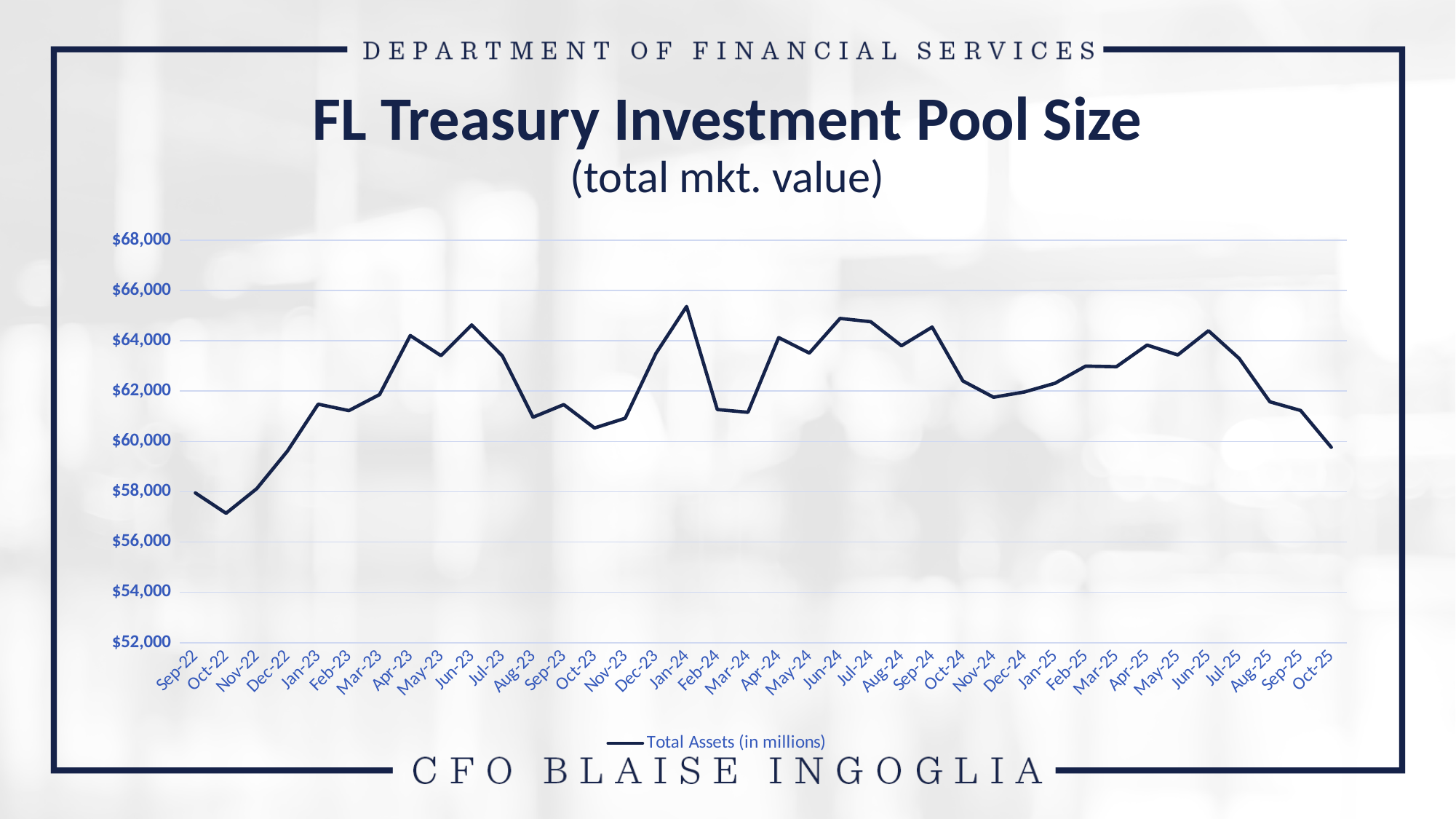
Which month has the highest total assets value? Jan-24 How many months are plotted along the x axis? 38 Is the value for Jan-24 greater or less than $64,000? greater Do the values rise or fall from Jun-25 to Oct-25? fall Which is larger, the value for Jan-24 or the value for Feb-24? Jan-24 What is the title of the chart? FL Treasury Investment Pool Size (total mkt. value) What is the legend entry for the plotted series? Total Assets (in millions) Which month has the lowest total assets value? Oct-22 What kind of chart is shown on the slide? Line chart How many series does the legend list? 1 Is the value for Oct-22 greater or less than $58,000? less Is the value for Oct-25 greater or less than $60,000? less